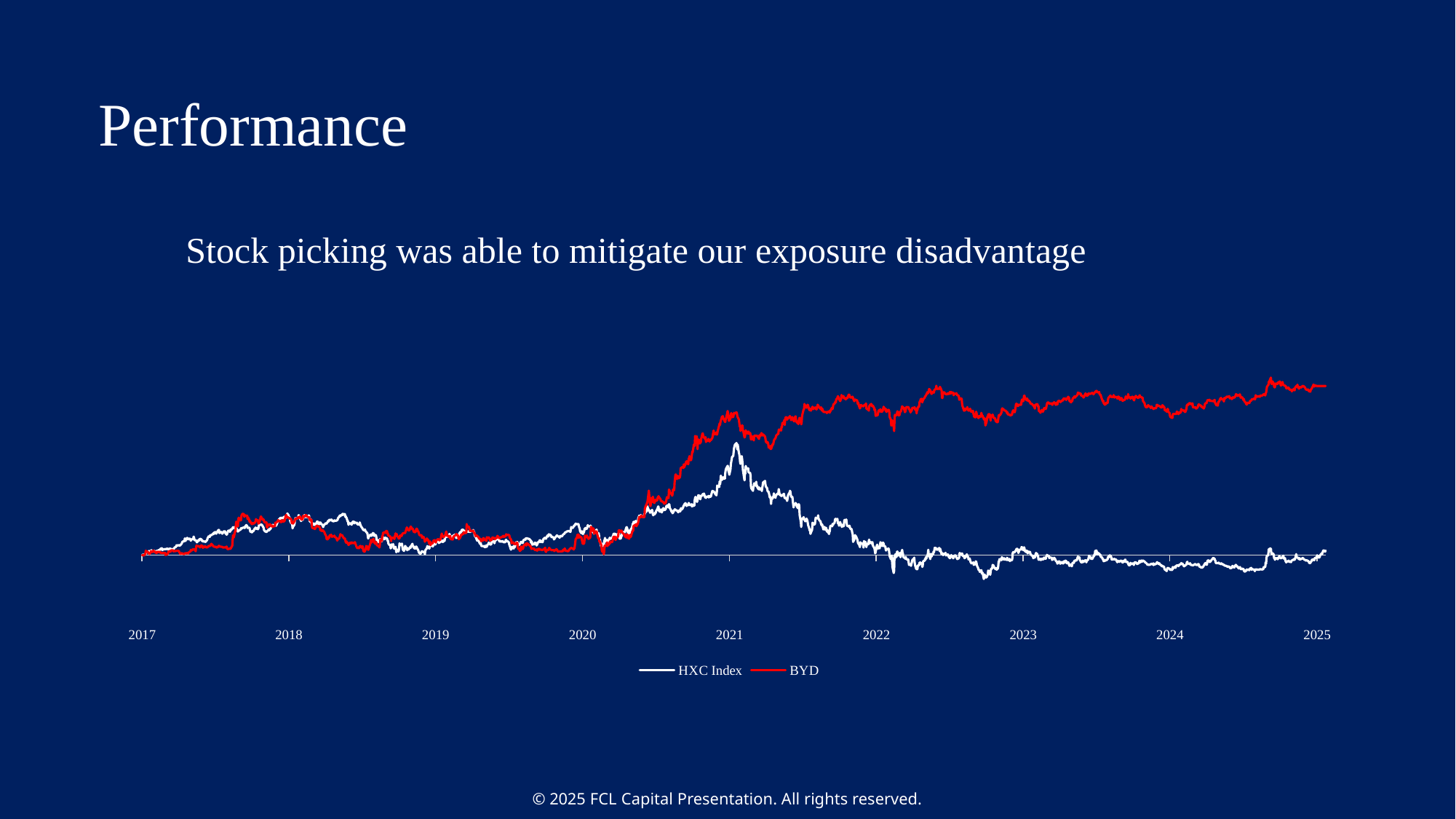
Does the BYD line overall rise or fall from 2017 to 2025? rise Which series reaches the highest point on the chart, HXC Index or BYD? BYD Does the HXC Index line rise or fall between its 2021 peak and 2023? fall What is the last year label on the x axis of the chart? 2025 What is the first year label on the x axis of the chart? 2017 How many year labels are shown along the x axis of the chart? 9 What kind of chart is shown on the slide? line chart Which series is higher at the 2024 mark on the chart, HXC Index or BYD? BYD How many series does the chart's legend list? 2 Which two series are listed in the chart's legend? HXC Index and BYD At the 2025 end of the chart, which series is higher, HXC Index or BYD? BYD What colour is the BYD line in the chart? red